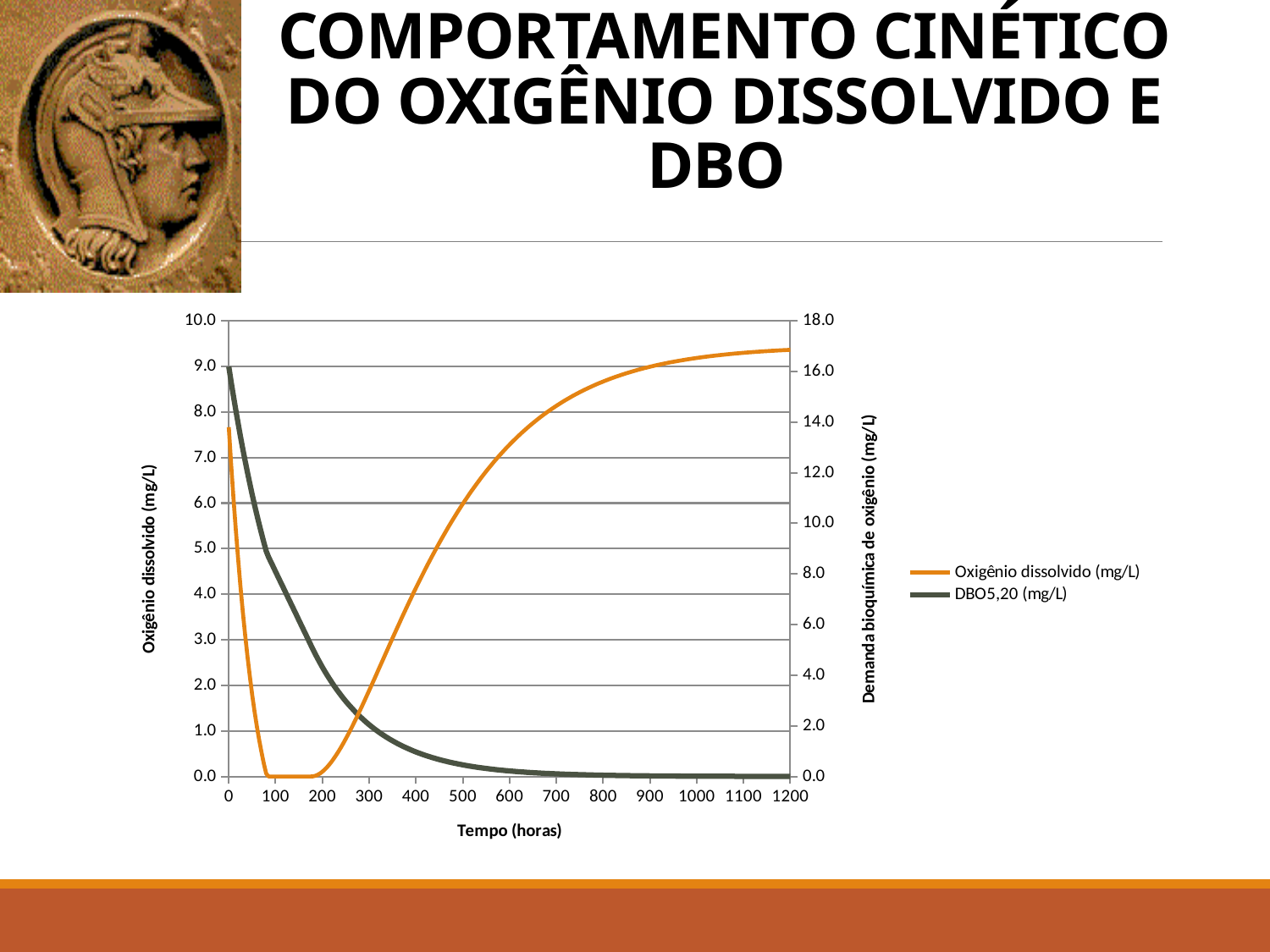
What is the label of the x axis of the chart? Tempo (horas) Does the Oxigênio dissolvido (mg/L) series rise or fall between 200 and 1200 hours? rise Does the DBO5,20 (mg/L) series rise or fall as time increases along the x axis? fall What kind of chart is shown on the slide? line chart Is the value of Oxigênio dissolvido (mg/L) at 1200 hours greater or less than 9.0? greater Is the value of DBO5,20 (mg/L) at 1200 hours greater or less than 2.0 on the right axis? less Is the value of Oxigênio dissolvido (mg/L) at 0 hours greater or less than 7.0? greater How many series does the legend list? 2 Which series is drawn in orange? Oxigênio dissolvido (mg/L)